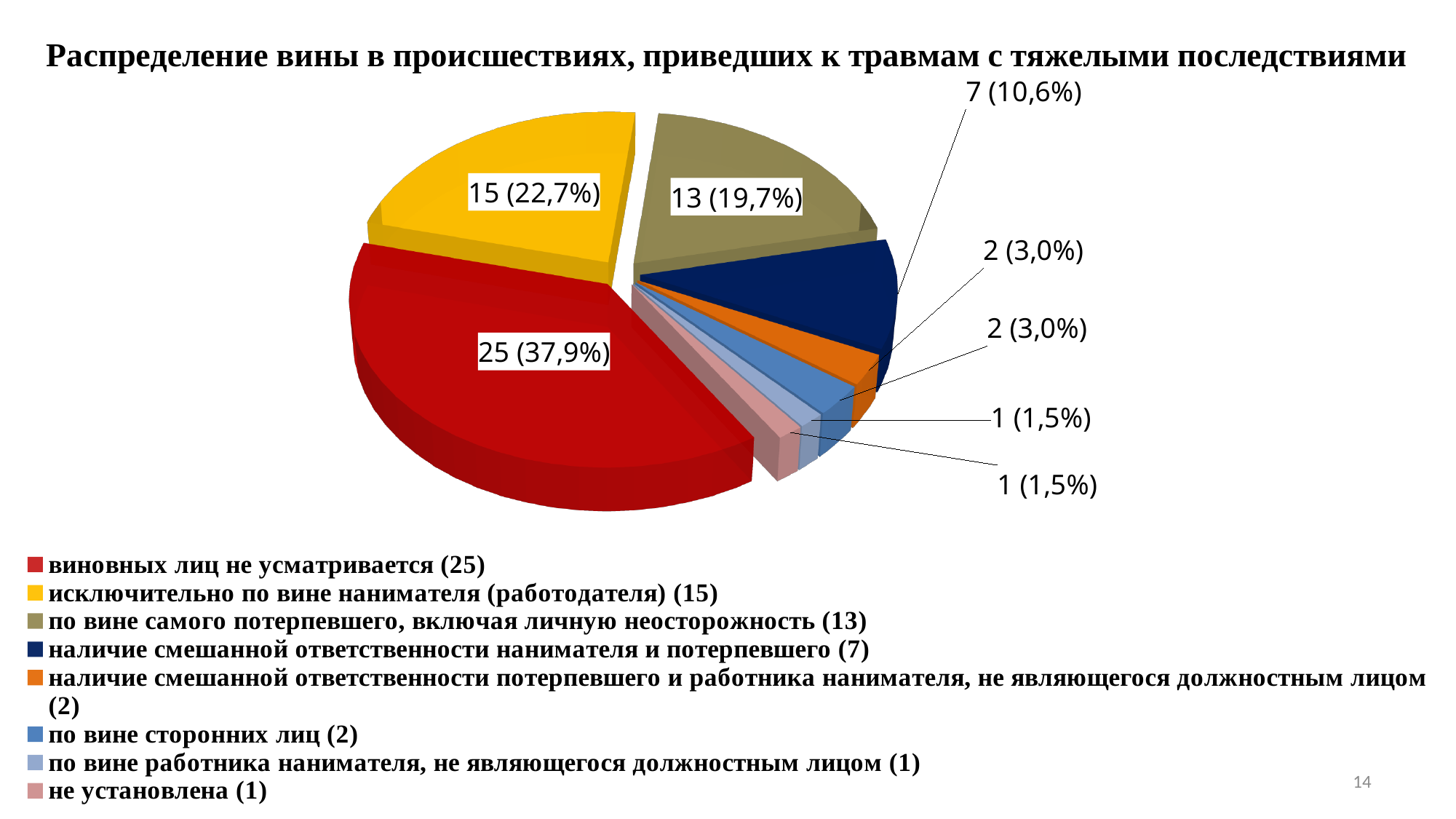
What is the difference between the values for "виновных лиц не усматривается" and "исключительно по вине нанимателя (работодателя)"? 10 What share of the pie does "не установлена" take? 1,5% What is the title of the chart? Распределение вины в происшествиях, приведших к травмам с тяжелыми последствиями What share of the pie does "исключительно по вине нанимателя (работодателя)" take? 22,7% What is the value for "наличие смешанной ответственности нанимателя и потерпевшего"? 7 Which category has the largest slice? виновных лиц не усматривается What kind of chart is shown on the slide? Pie chart What share of the pie does "по вине самого потерпевшего, включая личную неосторожность" take? 19,7% How many categories does the legend list? 8 What is the value for "по вине сторонних лиц"? 2 Which is larger: the value for "по вине самого потерпевшего, включая личную неосторожность" or for "наличие смешанной ответственности нанимателя и потерпевшего"? по вине самого потерпевшего, включая личную неосторожность What is the value for "виновных лиц не усматривается"? 25